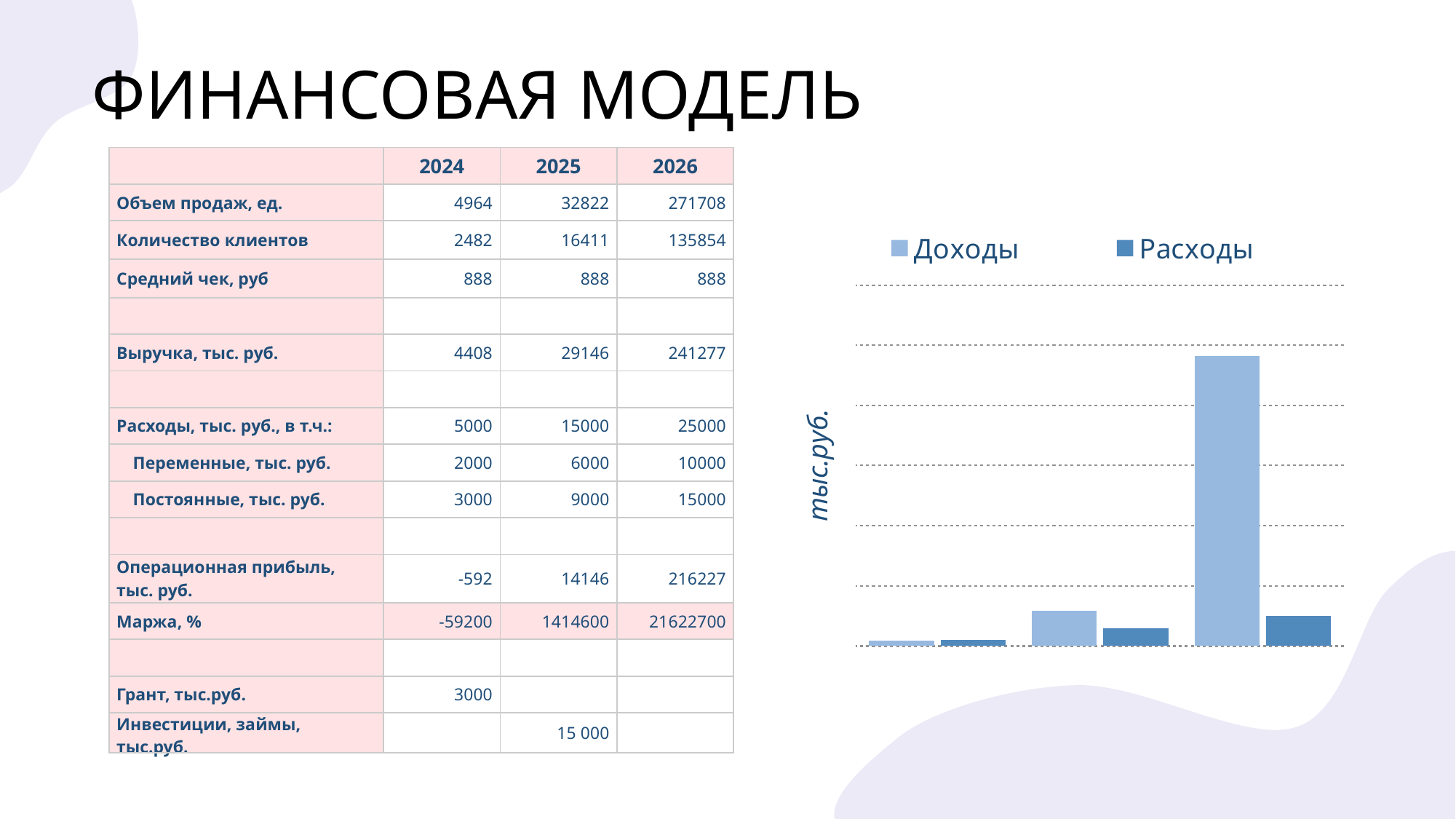
Do the Расходы bars rise or fall from left to right across the chart? rise What kind of chart is shown on the right side of the slide? bar chart What is the label on the vertical axis of the chart? тыс.руб. Which group of bars (leftmost, middle or rightmost) has the shortest Расходы bar? leftmost Which group of bars (leftmost, middle or rightmost) has the tallest Доходы bar? rightmost What are the two series named in the chart legend? Доходы and Расходы In the middle group of bars, which series is larger, Доходы or Расходы? Доходы In the rightmost group of bars, which series is larger, Доходы or Расходы? Доходы Do the Доходы bars rise or fall from left to right across the chart? rise How many bars in total are plotted in the chart? 6 How many groups of bars are plotted in the chart? 3 How many series does the chart legend list? 2